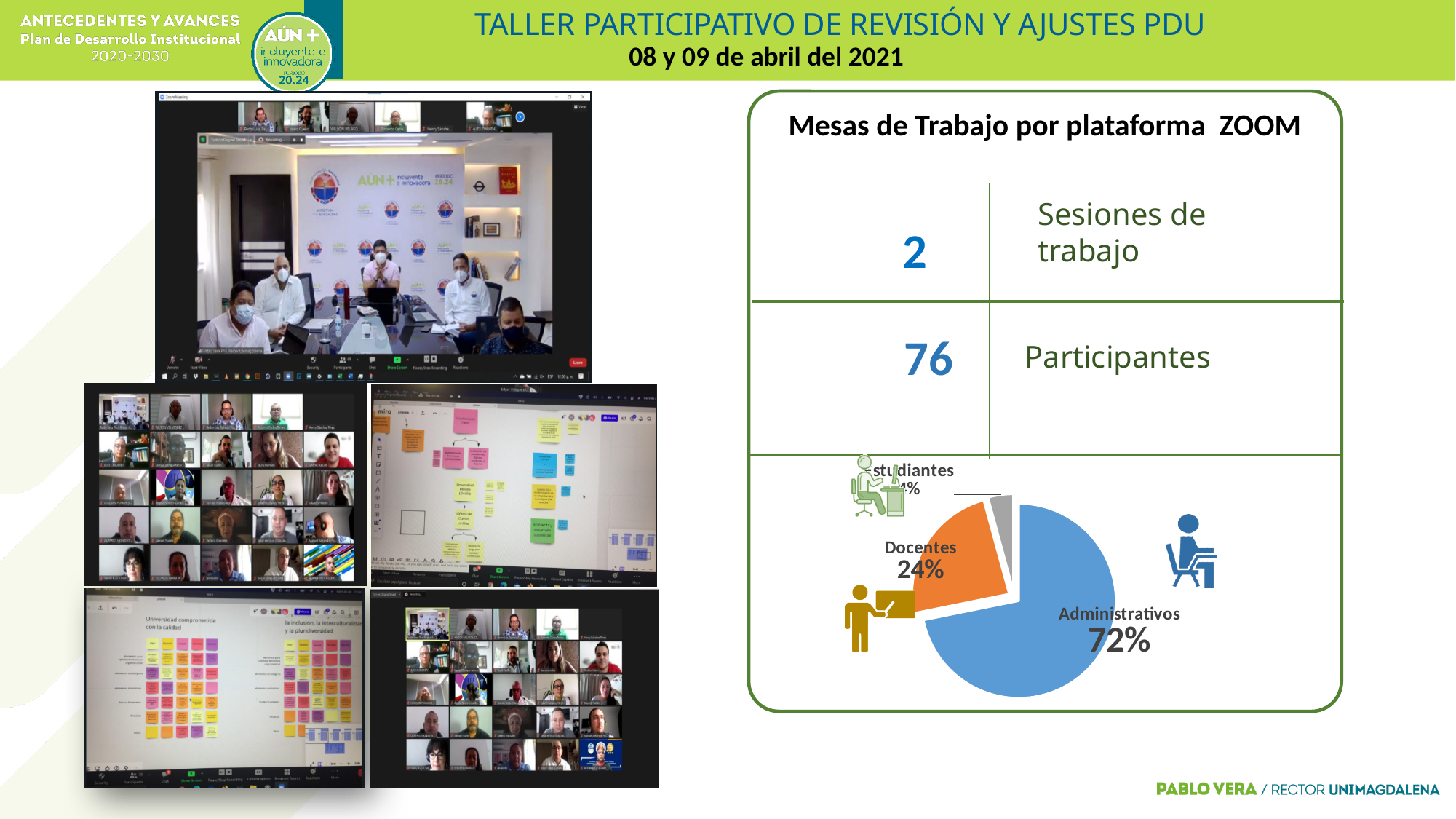
Which category has the largest slice of the pie chart? Administrativos Which slice is larger, Administrativos or Docentes? Administrativos What kind of chart is shown on the slide? pie chart Is the Administrativos share greater or less than 50%? greater What colour is the Administrativos slice of the pie chart? blue What share of the pie chart is Docentes? 24% What share of the pie chart is Administrativos? 72% What colour is the Docentes slice of the pie chart? orange Which category has the smallest slice of the pie chart? Estudiantes By how many percentage points does the Administrativos share exceed the Docentes share? 48 percentage points How many slices does the pie chart have? 3